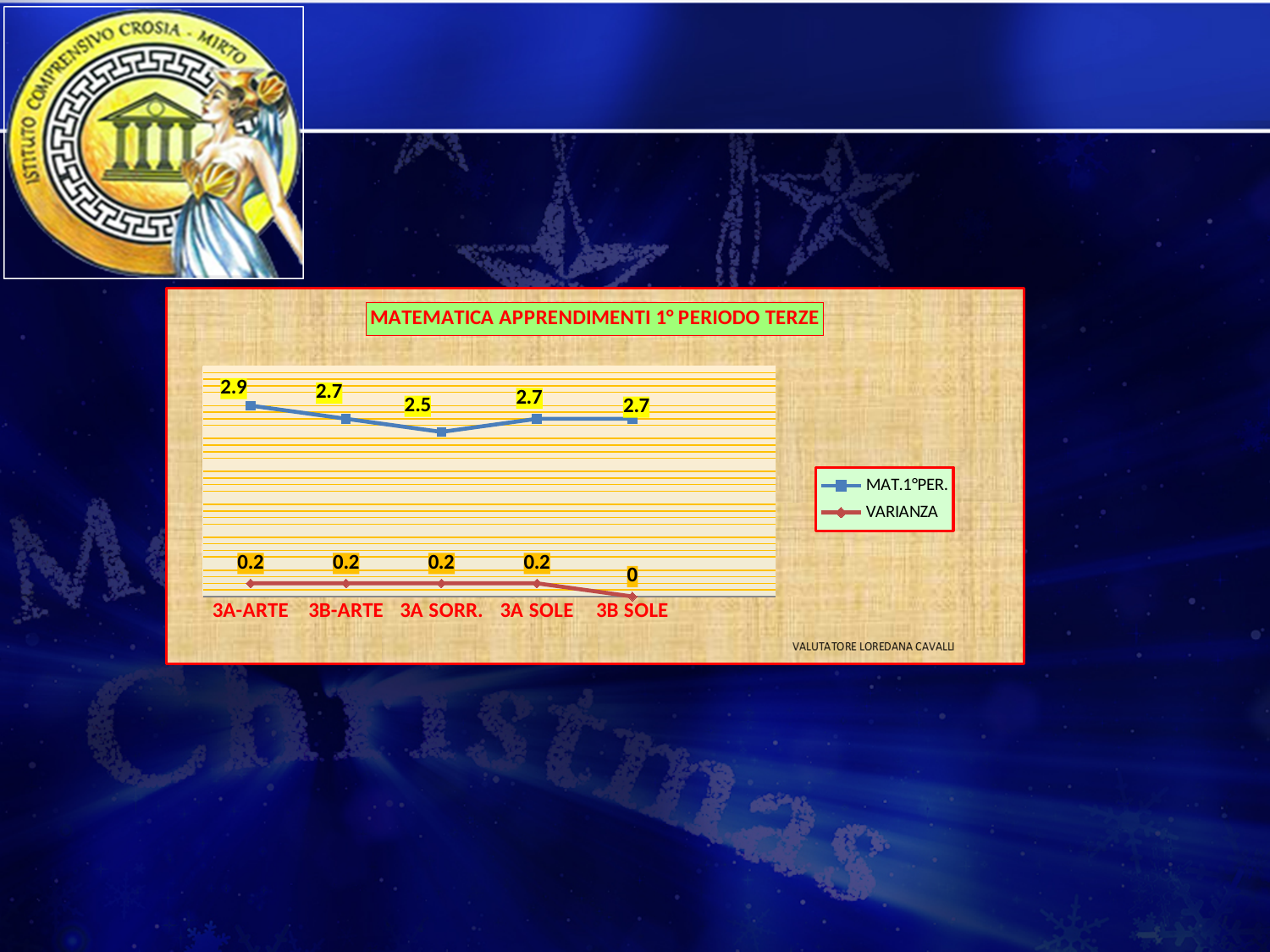
What is the VARIANZA value for 3A SOLE? 0.2 How many series does the legend list? 2 How many categories are shown on the x axis? 5 Which is larger, the MAT.1°PER. value for 3B-ARTE or for 3A SORR.? 3B-ARTE What is the difference between the MAT.1°PER. values for 3A-ARTE and 3A SORR.? 0.4 Which category has the lowest MAT.1°PER. value? 3A SORR. What kind of chart is shown? line chart What is the VARIANZA value for 3B SOLE? 0 What is the MAT.1°PER. value for 3A SORR.? 2.5 What is the title of the chart? MATEMATICA APPRENDIMENTI 1° PERIODO TERZE Which category has the highest MAT.1°PER. value? 3A-ARTE What is the MAT.1°PER. value for 3A-ARTE? 2.9